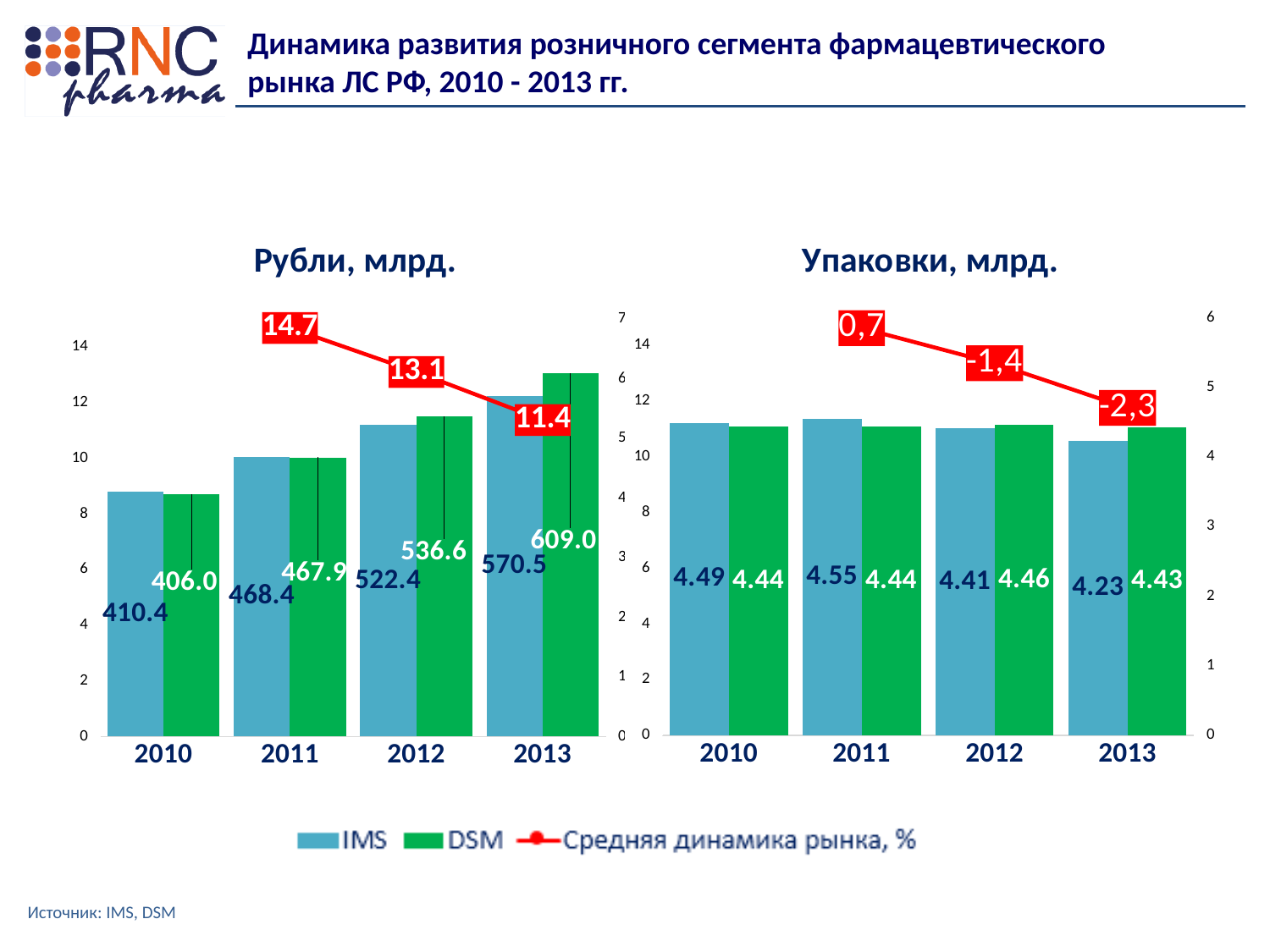
In the chart titled "Рубли, млрд.", what is the difference between the DSM and IMS values for 2013? 38.5 In the chart titled "Рубли, млрд.", which year has the highest DSM value? 2013 In the chart titled "Упаковки, млрд.", which is larger for 2013, the IMS value or the DSM value? DSM In the chart titled "Рубли, млрд.", what is the IMS value for 2010? 410.4 In the chart titled "Упаковки, млрд.", what is the IMS value for 2011? 4.55 In the chart titled "Упаковки, млрд.", which year has the lowest IMS value? 2013 How many series does the legend list? 3 In the chart titled "Упаковки, млрд.", what is the DSM value for 2012? 4.46 In the chart titled "Рубли, млрд.", what is the DSM value for 2013? 609.0 In the chart titled "Рубли, млрд.", what is the value of the "Средняя динамика рынка, %" line for 2012? 13.1 In the chart titled "Упаковки, млрд.", what is the value of the "Средняя динамика рынка, %" line for 2013? -2,3 In the chart titled "Рубли, млрд.", does the "Средняя динамика рынка, %" line rise or fall from 2011 to 2013? fall